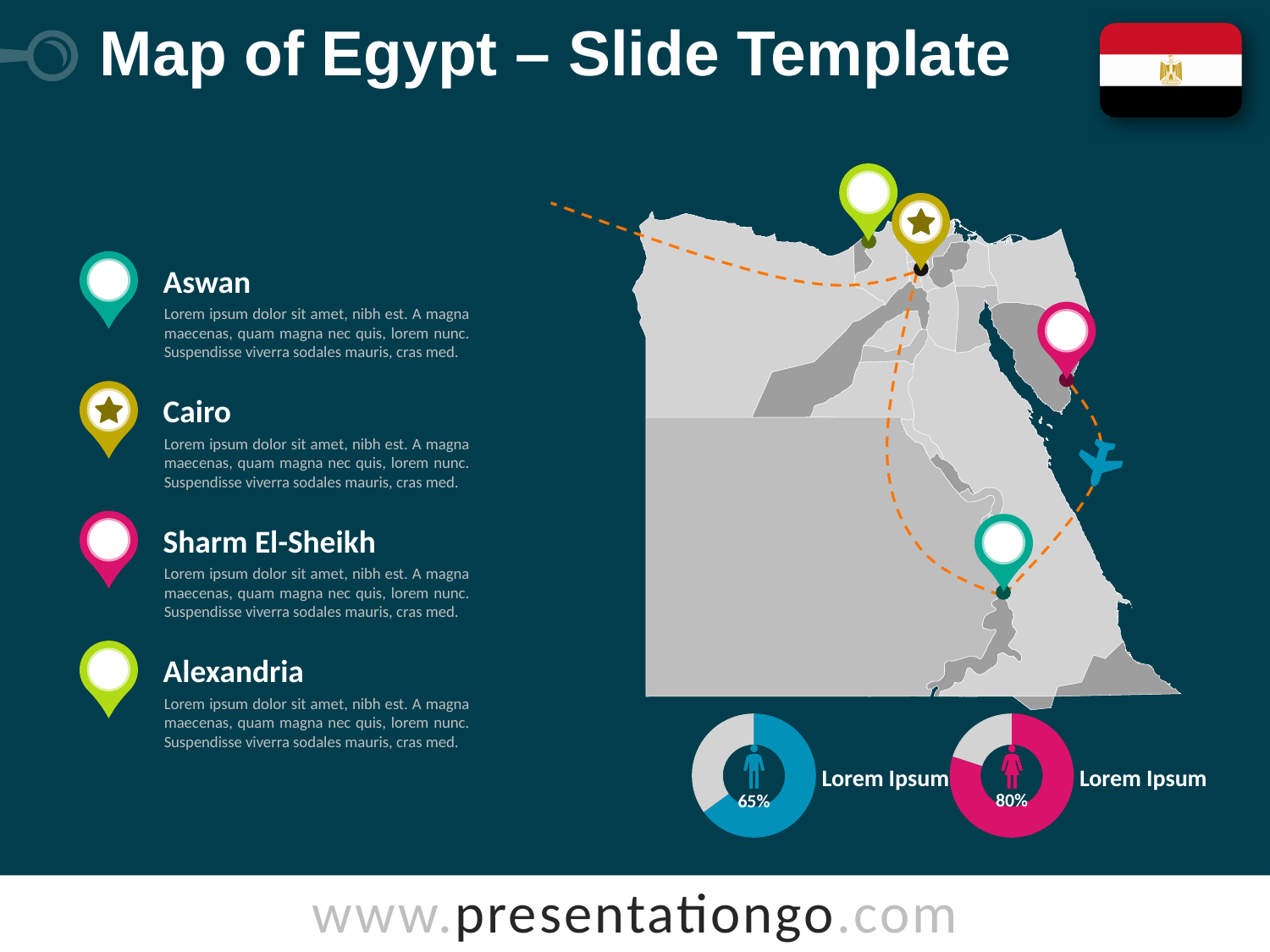
Is the value in the left donut chart greater or less than 50%? greater Is the value in the right donut chart greater or less than 75%? greater What label appears next to the left donut chart? Lorem Ipsum What colour is the filled portion of the left donut chart? blue Which of the two donut charts at the bottom of the slide shows the higher value, the left one or the right one? the right one What is the difference between the value in the right donut chart and the value in the left donut chart? 15% What kind of chart is used to display the 65% and 80% values at the bottom of the slide? donut chart What value is shown in the right donut chart at the bottom of the slide? 80% What value is shown in the left donut chart at the bottom of the slide? 65% What colour is the filled portion of the right donut chart? pink How many donut charts are shown at the bottom of the slide? 2